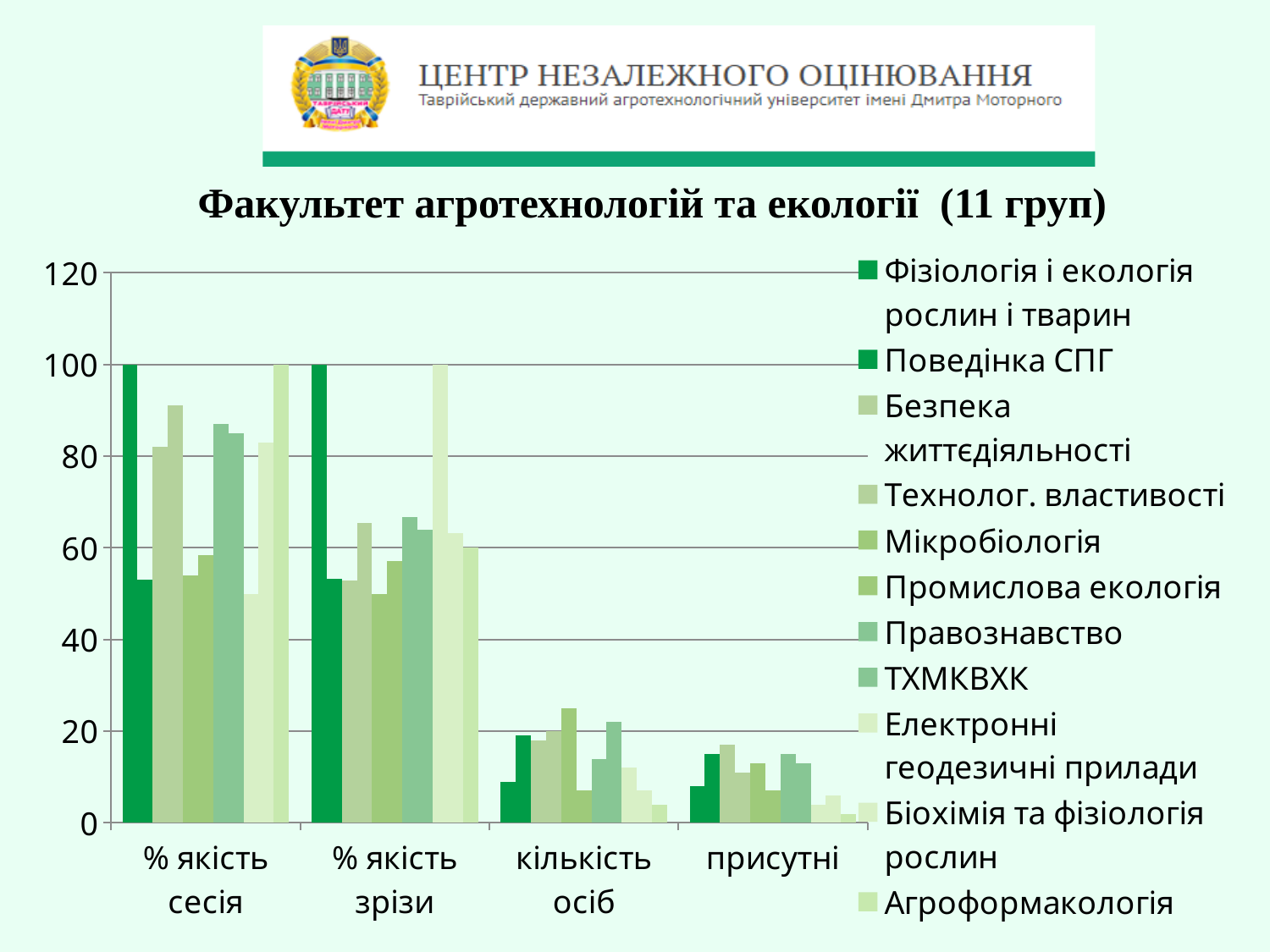
What is the highest value shown on the vertical axis of the chart? 120 What is the title of the chart? Факультет агротехнологій та екології (11 груп) How many categories are shown on the x axis of the chart? 4 For Фізіологія і екологія рослин і тварин, which is larger: the value in % якість сесія or the value in кількість осіб? % якість сесія What is the value for Фізіологія і екологія рослин і тварин in the % якість зрізи category? 100 What is the first entry listed in the chart legend? Фізіологія і екологія рослин і тварин How many series does the legend list? 11 Is the value for Фізіологія і екологія рослин і тварин in the присутні category greater or less than 20? less What kind of chart is shown on the slide? bar chart What is the value for Фізіологія і екологія рослин і тварин in the % якість сесія category? 100 Do the values for Фізіологія і екологія рослин і тварин rise or fall from % якість сесія to присутні along the x axis? fall Is the value for Фізіологія і екологія рослин і тварин in the кількість осіб category greater or less than 20? less